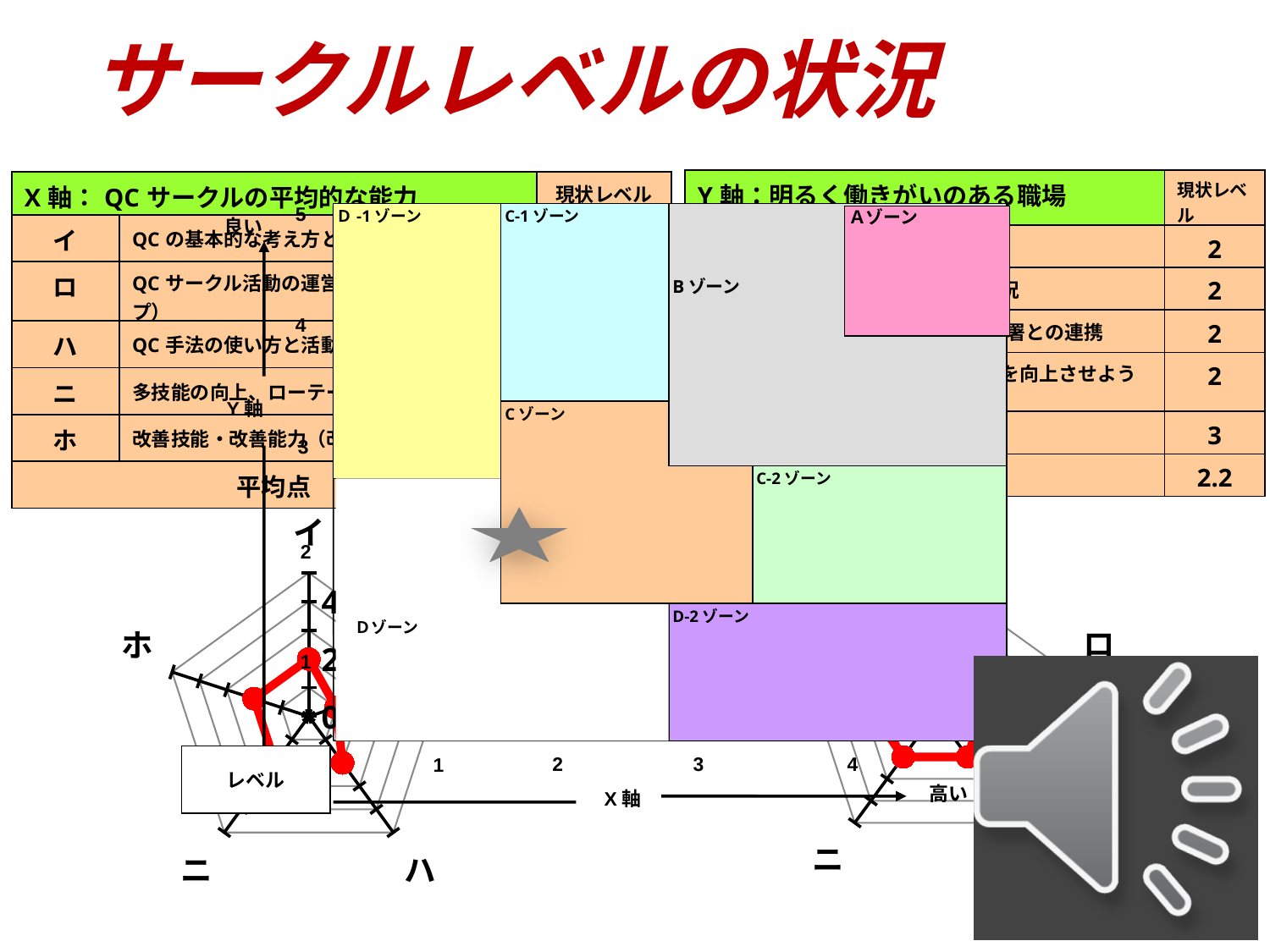
How many axes (categories) does the bottom-left radar chart have? 5 On the zone map in the centre of the slide, which zone contains the star marker? C ゾーン How many labelled zones are shown on the zone map in the centre of the slide? 8 What kind of chart is the chart at the bottom left of the slide with the axes イ, ホ, ニ, ハ? radar chart On the zone map in the centre of the slide, is the X 軸 value of the star marker greater or less than 1? greater